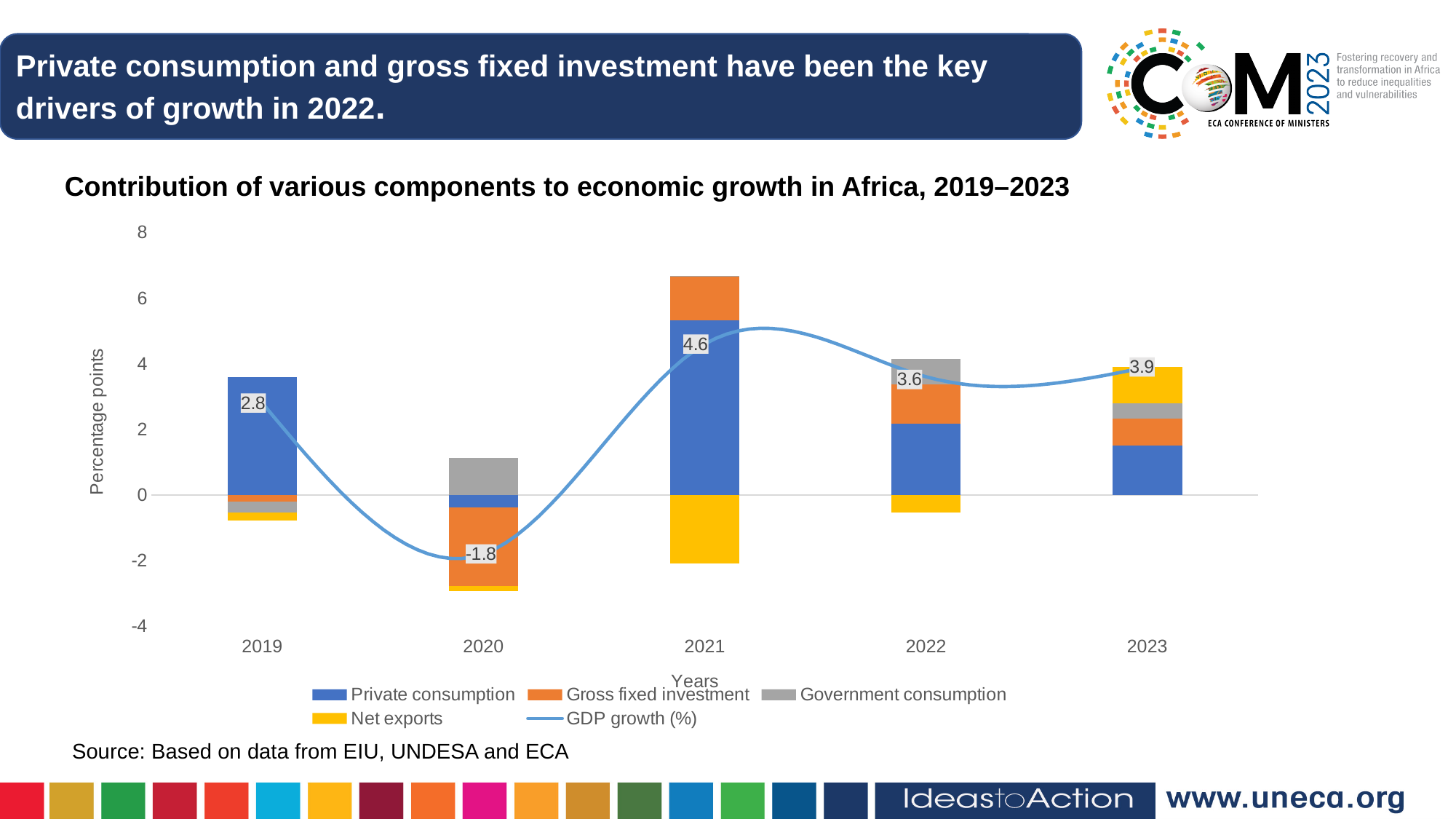
What is the GDP growth (%) value shown for 2020? -1.8 Is the Private consumption value for 2021 greater or less than 4? greater Which year has the highest GDP growth (%) value? 2021 Which year has the lowest GDP growth (%) value? 2020 Which year has the larger GDP growth (%) value, 2022 or 2023? 2023 How many series does the legend list? 5 How many years are shown on the x axis? 5 What is the GDP growth (%) value shown for 2023? 3.9 What kind of chart is shown on the slide? Stacked bar chart with a line What is the label on the y axis of the chart? Percentage points What is the difference between the GDP growth (%) values for 2021 and 2019? 1.8 What is the GDP growth (%) value shown for 2021? 4.6